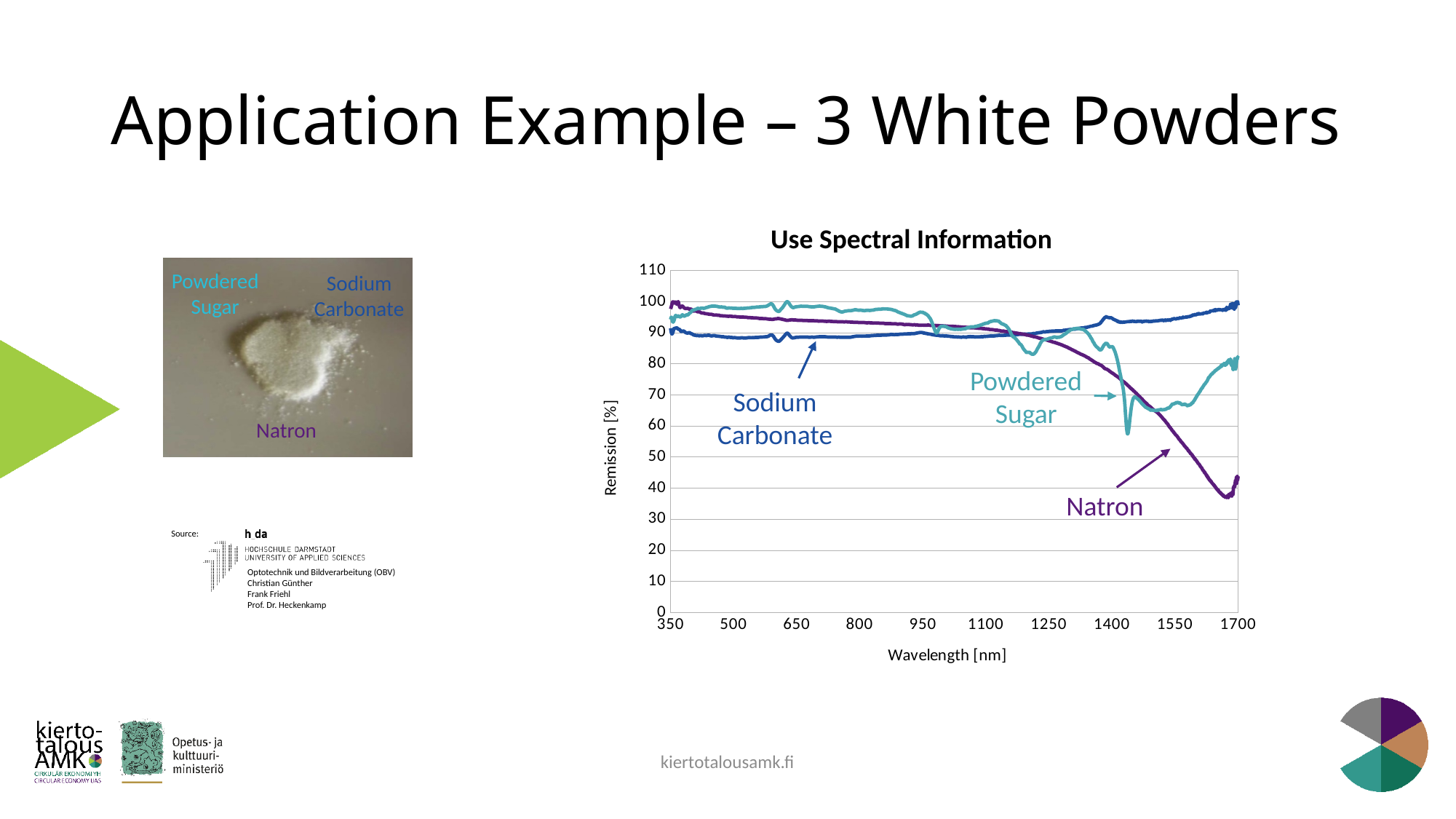
Is the Natron remission value at 350 nm greater or less than 90? greater What is the label of the x axis of the chart? Wavelength [nm] Is the Natron remission value at 1700 nm greater or less than 50? less How many series (powders) are plotted on the chart? 3 What is the title of the chart? Use Spectral Information Which series reaches the lowest remission value anywhere on the chart? Natron Does the Natron line rise or fall as wavelength increases from 350 nm to 1700 nm? fall Is the Sodium Carbonate remission value at 1700 nm greater or less than 90? greater At 1700 nm, which has the higher remission: Sodium Carbonate or Natron? Sodium Carbonate What kind of chart is shown under the title "Use Spectral Information"? line chart Which series has the lowest remission value at 1700 nm? Natron